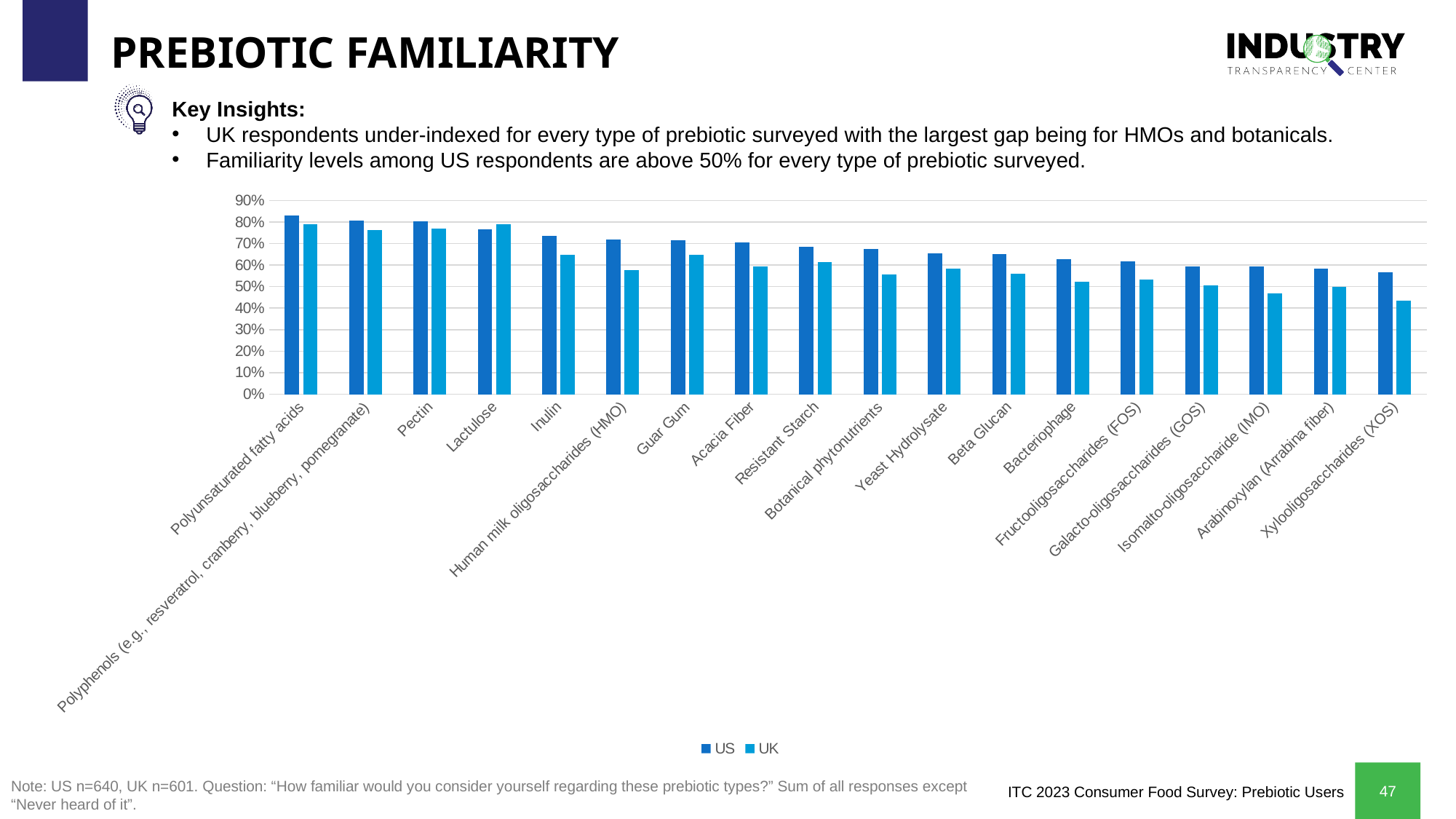
How many prebiotic types are shown on the x axis? 18 Is the UK value for Human milk oligosaccharides (HMO) greater or less than 60%? less Is the US value for Polyunsaturated fatty acids greater or less than 80%? greater Is the UK value for Xylooligosaccharides (XOS) greater or less than 50%? less Which series is shown in the darker blue bars? US Which prebiotic type has the highest US familiarity value? Polyunsaturated fatty acids For Botanical phytonutrients, which series has the larger value, US or UK? US Do the US values generally rise or fall moving from left to right along the x axis? fall Which prebiotic type has the lowest UK familiarity value? Xylooligosaccharides (XOS) What kind of chart is shown on the slide? bar chart How many series does the legend list? 2